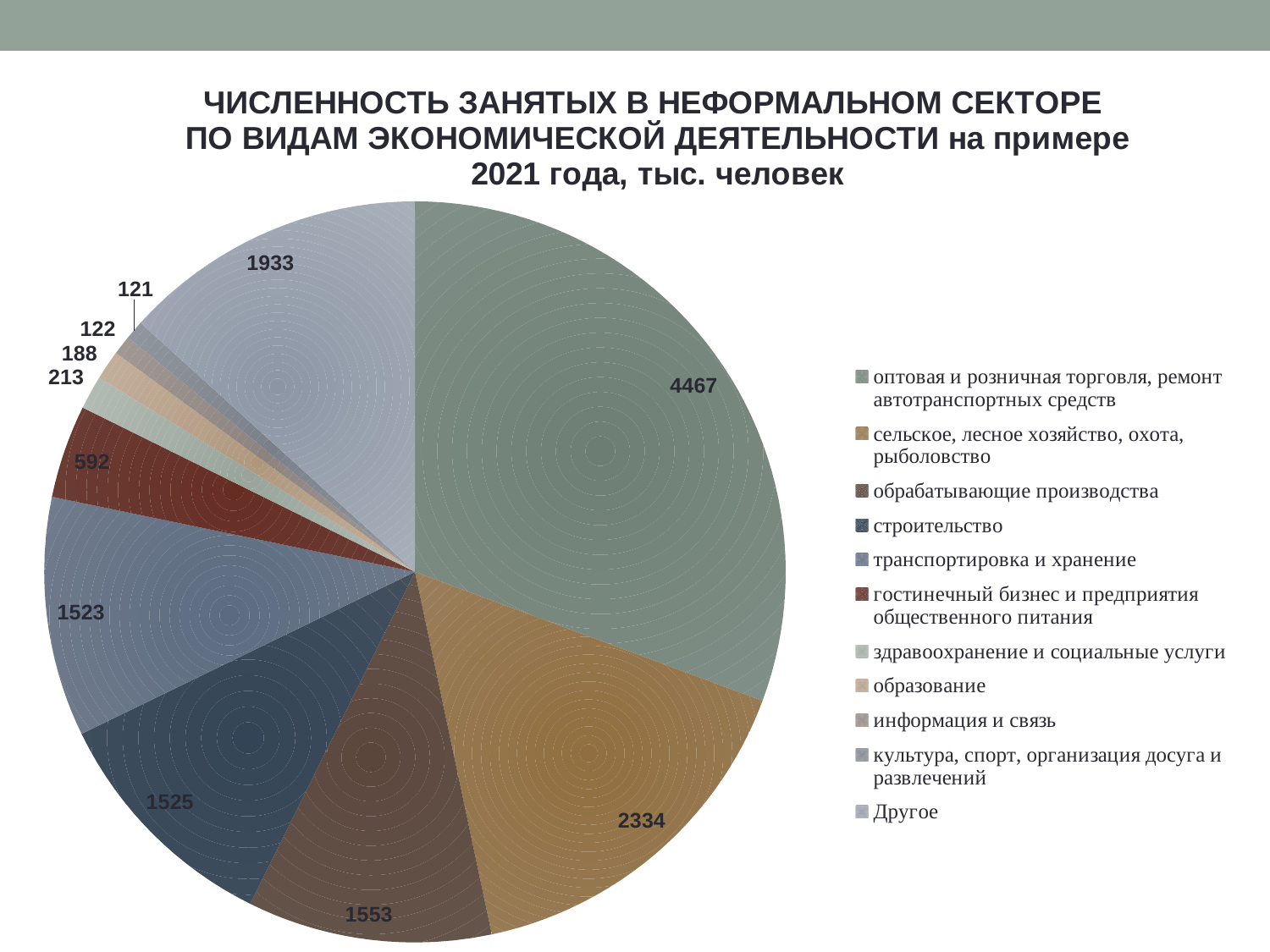
What is the value for гостиничный бизнес и предприятия общественного питания? 592 What kind of chart is shown on the slide? Pie chart Which category has the smallest slice of the pie? культура, спорт, организация досуга и развлечений What unit of measurement is stated in the chart title? тыс. человек What is the value for сельское, лесное хозяйство, охота, рыболовство? 2334 What is the value for образование? 188 What is the value for the Другое slice? 1933 What is the difference between the values for оптовая и розничная торговля and сельское, лесное хозяйство, охота, рыболовство? 2133 Which category has the largest slice of the pie? оптовая и розничная торговля, ремонт автотранспортных средств How many slices does the pie chart have? 11 What is the value for оптовая и розничная торговля, ремонт автотранспортных средств? 4467 Which is larger: the value for обрабатывающие производства or the value for гостиничный бизнес и предприятия общественного питания? обрабатывающие производства